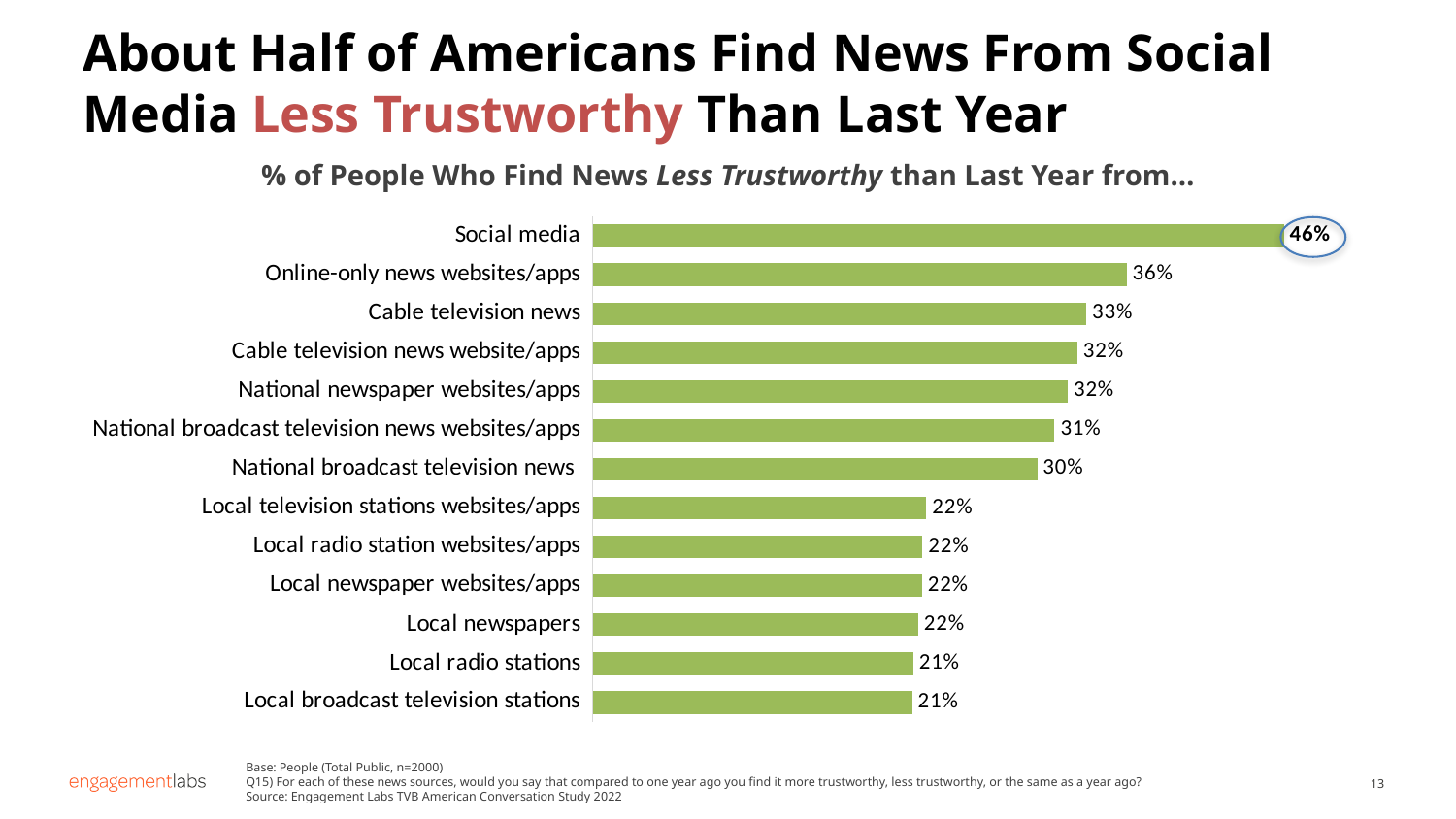
What is the value shown for National broadcast television news? 30% Which has a larger value, National newspaper websites/apps or Local television stations websites/apps? National newspaper websites/apps What is the difference between the values for Social media and Online-only news websites/apps? 10% What kind of chart is shown on the slide? Bar chart What is the value shown for Cable television news? 33% What percentage of people find news from social media less trustworthy than last year? 46% What is the value shown for Online-only news websites/apps? 36% How many news sources are shown in the chart? 13 What is the title of the chart? % of People Who Find News Less Trustworthy than Last Year from… What is the difference between the values for Cable television news and Local radio stations? 12% What is the value shown for Local newspapers? 22% Which news source has the highest share of people finding it less trustworthy than last year? Social media